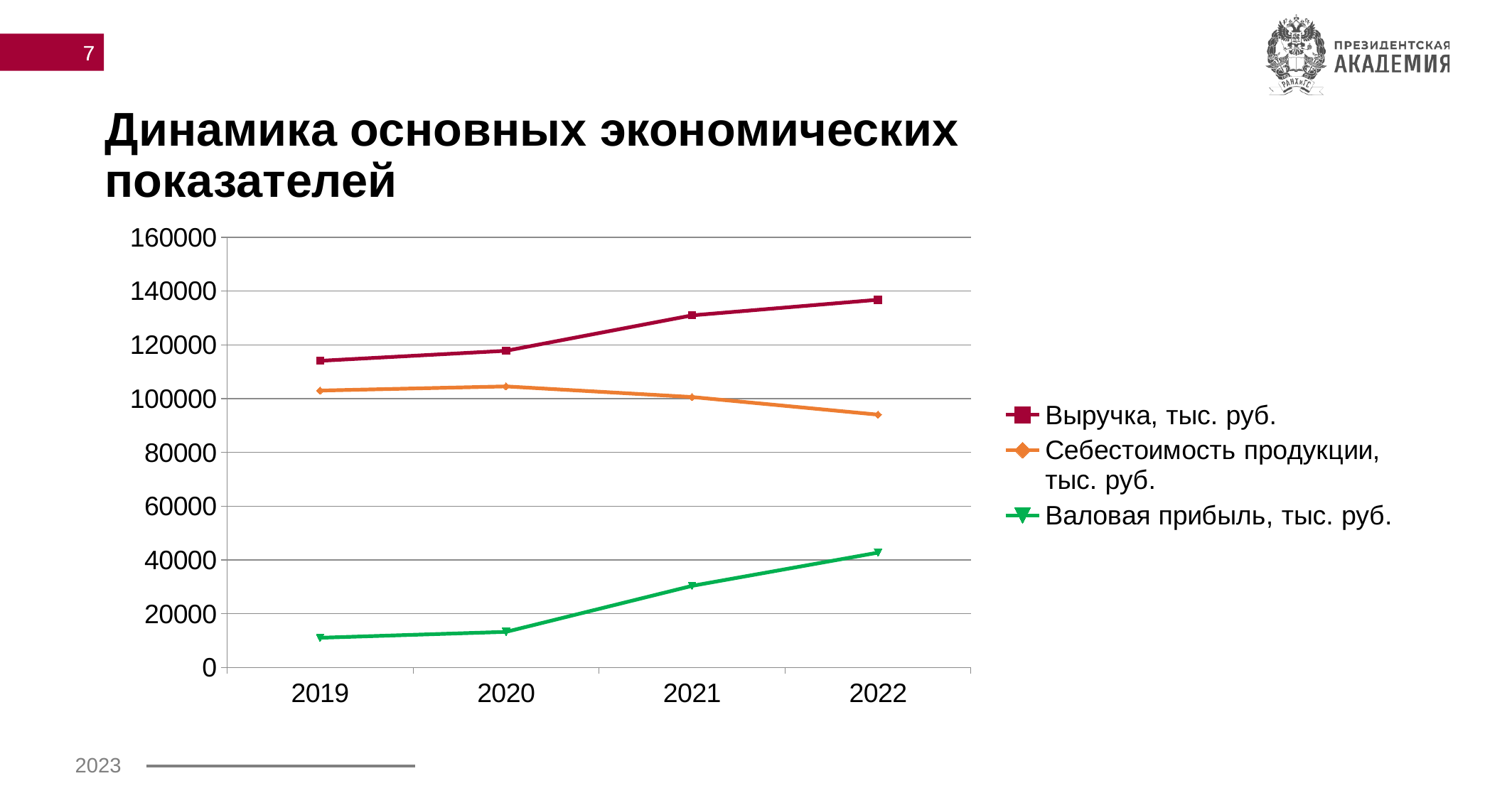
How many series does the legend list? 3 How many years are shown on the x axis? 4 Which is larger in 2021: Выручка, тыс. руб. or Себестоимость продукции, тыс. руб.? Выручка, тыс. руб. What kind of chart is shown on the slide? line chart Is the value for Себестоимость продукции, тыс. руб. in 2022 greater or less than 100000? less Is the value for Выручка, тыс. руб. in 2022 greater or less than 120000? greater Does the value for Выручка, тыс. руб. rise or fall from 2019 to 2022? rise In which year is Выручка, тыс. руб. lowest? 2019 Is the value for Валовая прибыль, тыс. руб. in 2019 greater or less than 20000? less Does the value for Валовая прибыль, тыс. руб. rise or fall from 2019 to 2022? rise In which year is Валовая прибыль, тыс. руб. highest? 2022 Does the value for Себестоимость продукции, тыс. руб. rise or fall from 2020 to 2022? fall